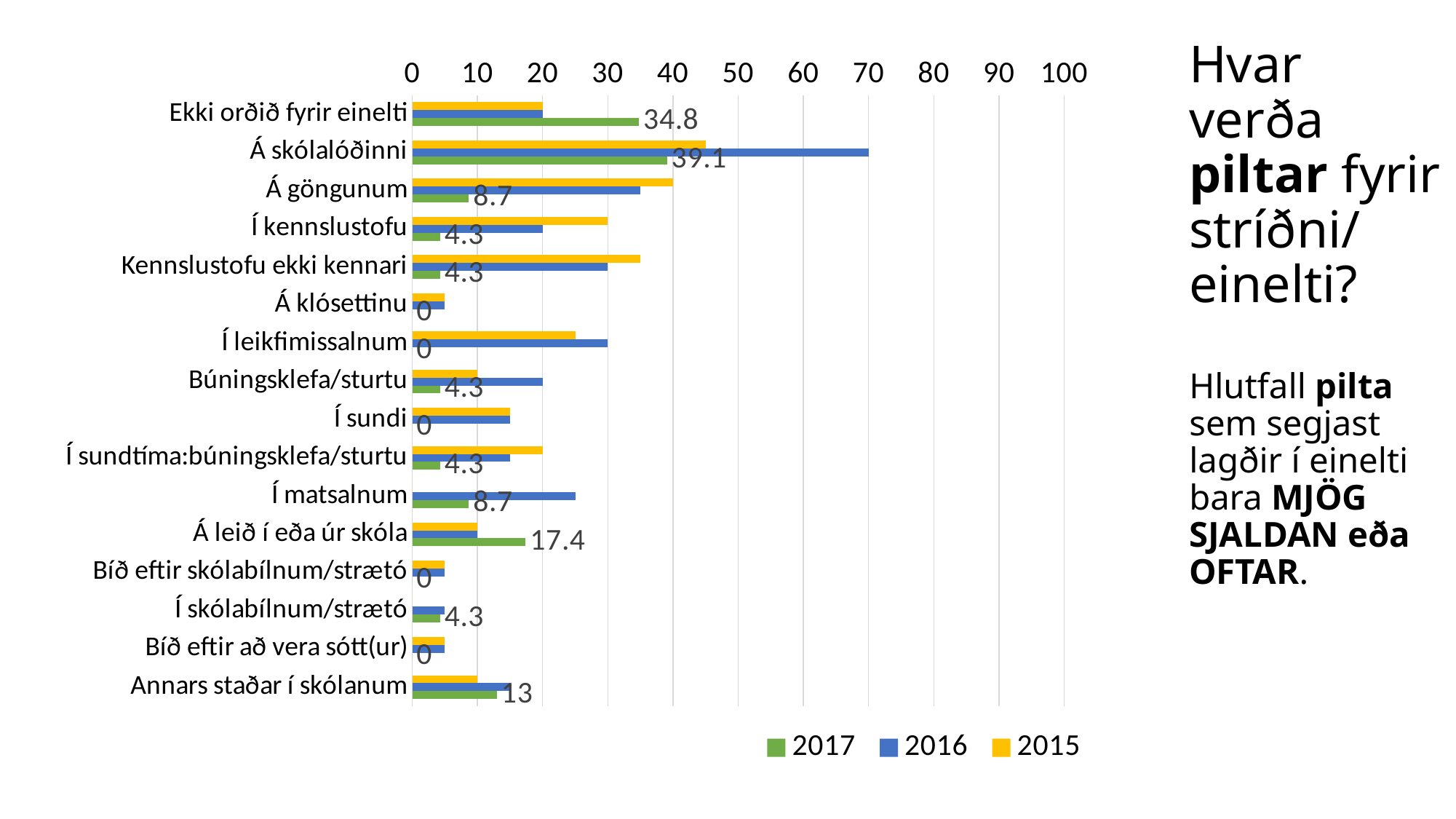
How many categories are shown on the chart? 16 What is the difference between the 2017 values for "Á skólalóðinni" and "Ekki orðið fyrir einelti"? 4.3 What is the 2017 value for "Annars staðar í skólanum"? 13 What kind of chart is shown on the slide? Bar chart What is the 2017 value for "Á skólalóðinni"? 39.1 How many series does the legend list? 3 Which category has the highest 2017 value? Á skólalóðinni Is the 2016 value for "Í leikfimissalnum" greater or less than 20? greater What is the 2017 value for "Ekki orðið fyrir einelti"? 34.8 What is the 2017 value for "Á leið í eða úr skóla"? 17.4 Which is larger for 2017: "Á göngunum" or "Á leið í eða úr skóla"? Á leið í eða úr skóla Is the 2016 value for "Á skólalóðinni" greater or less than 60? greater